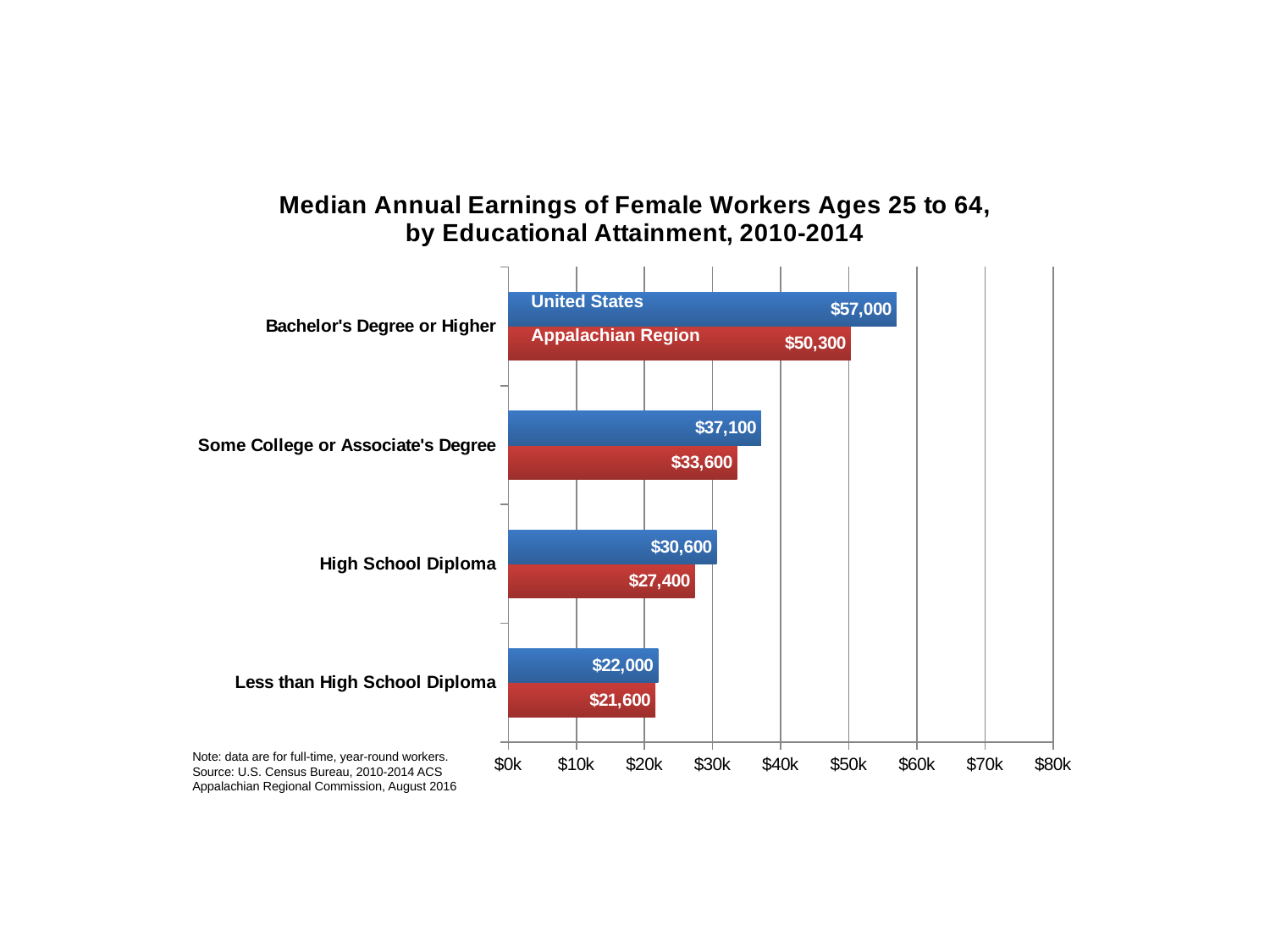
What is the median annual earnings for Appalachian Region female workers with Some College or Associate's Degree? $33,600 How many educational attainment categories are shown in the chart? 4 How many series does the chart show? 2 What is the median annual earnings for Appalachian Region female workers with a High School Diploma? $27,400 Which educational attainment category has the highest median annual earnings for the United States? Bachelor's Degree or Higher What is the difference between United States and Appalachian Region median earnings for workers with Less than High School Diploma? $400 What type of chart is shown on the slide? Bar chart Which is larger: United States median earnings for High School Diploma or Appalachian Region median earnings for Some College or Associate's Degree? Appalachian Region median earnings for Some College or Associate's Degree Is the Appalachian Region value for Bachelor's Degree or Higher greater or less than $50k? greater Which educational attainment category has the lowest median annual earnings for the Appalachian Region? Less than High School Diploma What is the difference between United States and Appalachian Region median earnings for workers with a Bachelor's Degree or Higher? $6,700 What is the median annual earnings for United States female workers with a Bachelor's Degree or Higher? $57,000